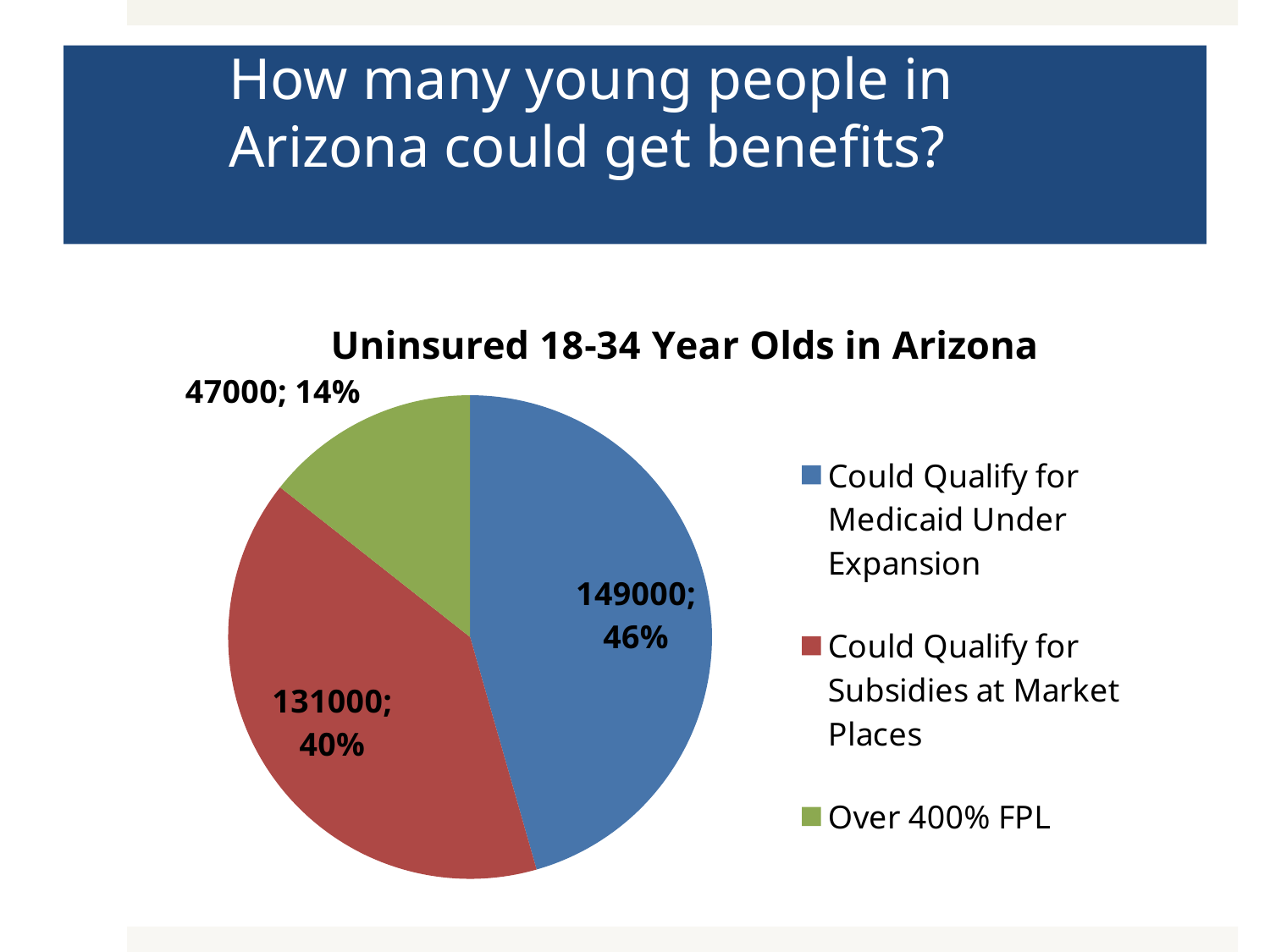
How many entries does the legend list? 3 Which category has the smallest slice? Over 400% FPL How many uninsured 18-34 year olds are over 400% FPL? 47000 Which category has the largest slice? Could Qualify for Medicaid Under Expansion How many uninsured 18-34 year olds could qualify for subsidies at market places? 131000 What share of the pie is the 'Over 400% FPL' slice? 14% What kind of chart is shown on the slide? pie chart What is the title of the chart? Uninsured 18-34 Year Olds in Arizona How many slices does the pie chart have? 3 How many uninsured 18-34 year olds could qualify for Medicaid under expansion? 149000 What is the difference between the number who could qualify for Medicaid under expansion and the number who could qualify for subsidies at market places? 18000 What share of the pie is the 'Could Qualify for Medicaid Under Expansion' slice? 46%